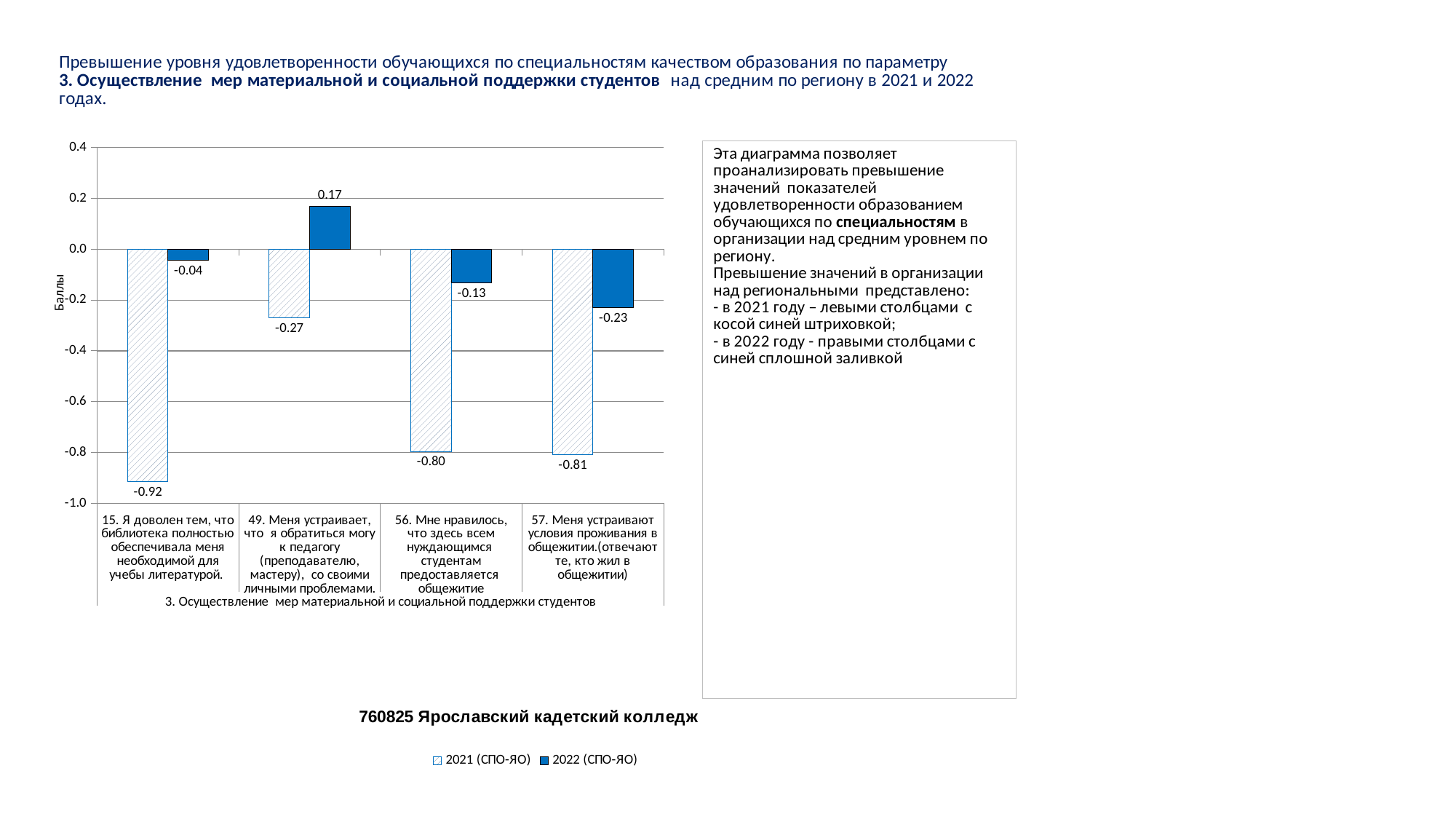
Which is larger for item 57: the 2021 (СПО-ЯО) value or the 2022 (СПО-ЯО) value? 2022 (СПО-ЯО) Which item has the highest 2022 (СПО-ЯО) value? 49. Меня устраивает, что я обратиться могу к педагогу (преподавателю, мастеру), со своими личными проблемами. What type of chart is shown on the slide? Bar chart What is the 2022 (СПО-ЯО) value for item 49 (can approach a teacher with personal problems)? 0.17 Which item has the lowest 2021 (СПО-ЯО) value? 15. Я доволен тем, что библиотека полностью обеспечивала меня необходимой для учебы литературой. What is the label of the vertical axis of the chart? Баллы What is the 2021 (СПО-ЯО) value for item 56 (dormitory provided to all students in need)? -0.80 How many items (categories) are shown on the x axis of the chart? 4 How many series does the legend list? 2 What is the 2021 (СПО-ЯО) value for item 15 (library provided necessary literature)? -0.92 What is the 2022 (СПО-ЯО) value for item 57 (dormitory living conditions)? -0.23 What is the difference between the 2022 and 2021 values for item 15? 0.88